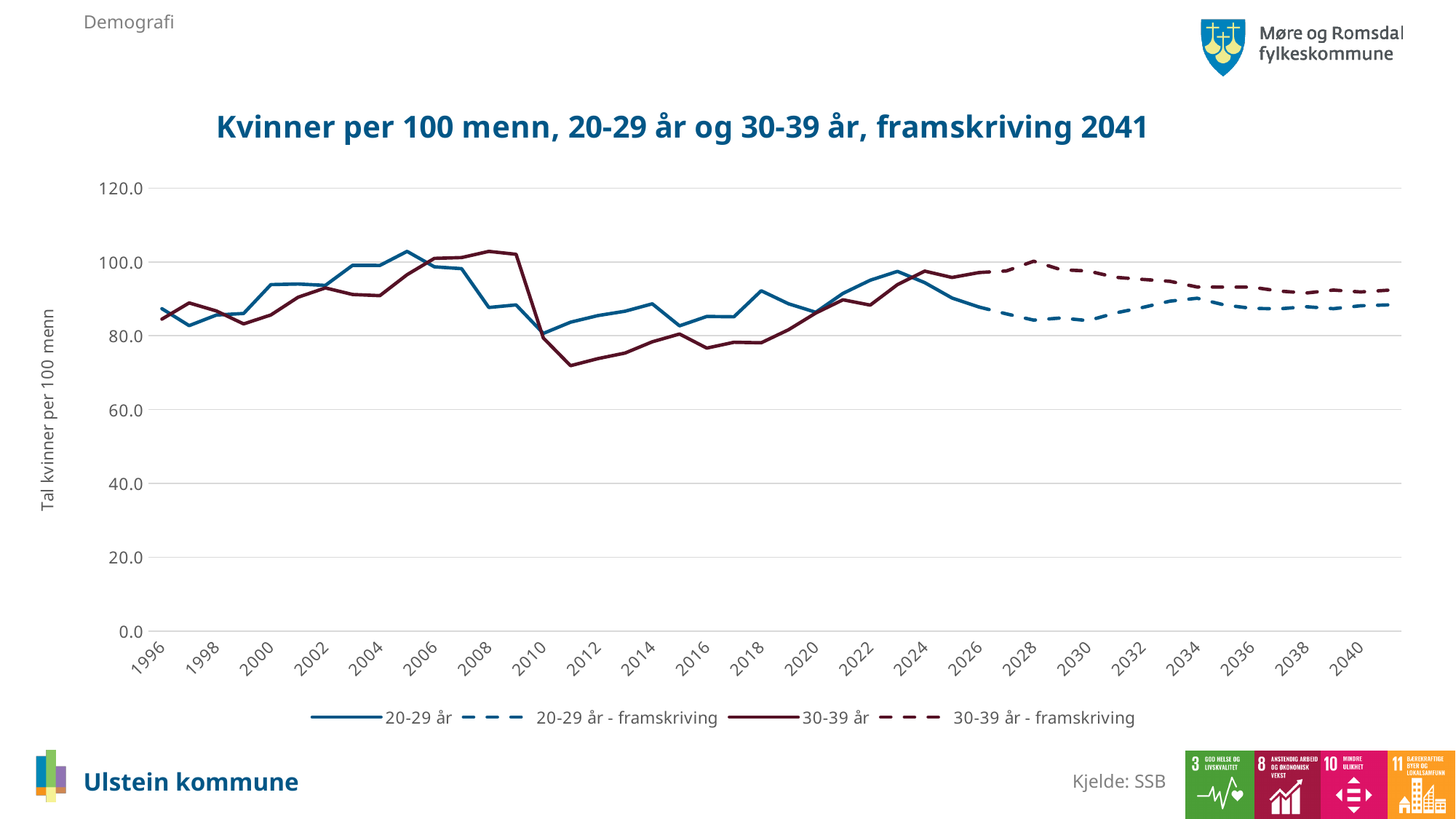
Is the value for 20-29 år - framskriving in 2029 greater or less than 80? greater What kind of chart is shown on the slide? line chart In 2008, which series has the higher value: 20-29 år or 30-39 år? 30-39 år What is the title of the chart? Kvinner per 100 menn, 20-29 år og 30-39 år, framskriving 2041 In which year does the 30-39 år line reach its lowest value? 2011 What is the label on the vertical axis of the chart? Tal kvinner per 100 menn Is the value for 20-29 år in 2005 greater or less than 100? greater Is the value for 30-39 år in 2011 greater or less than 80? less In 2011, which series has the higher value: 20-29 år or 30-39 år? 20-29 år Does the 30-39 år line rise or fall between 2008 and 2011? fall How many series does the legend list? 4